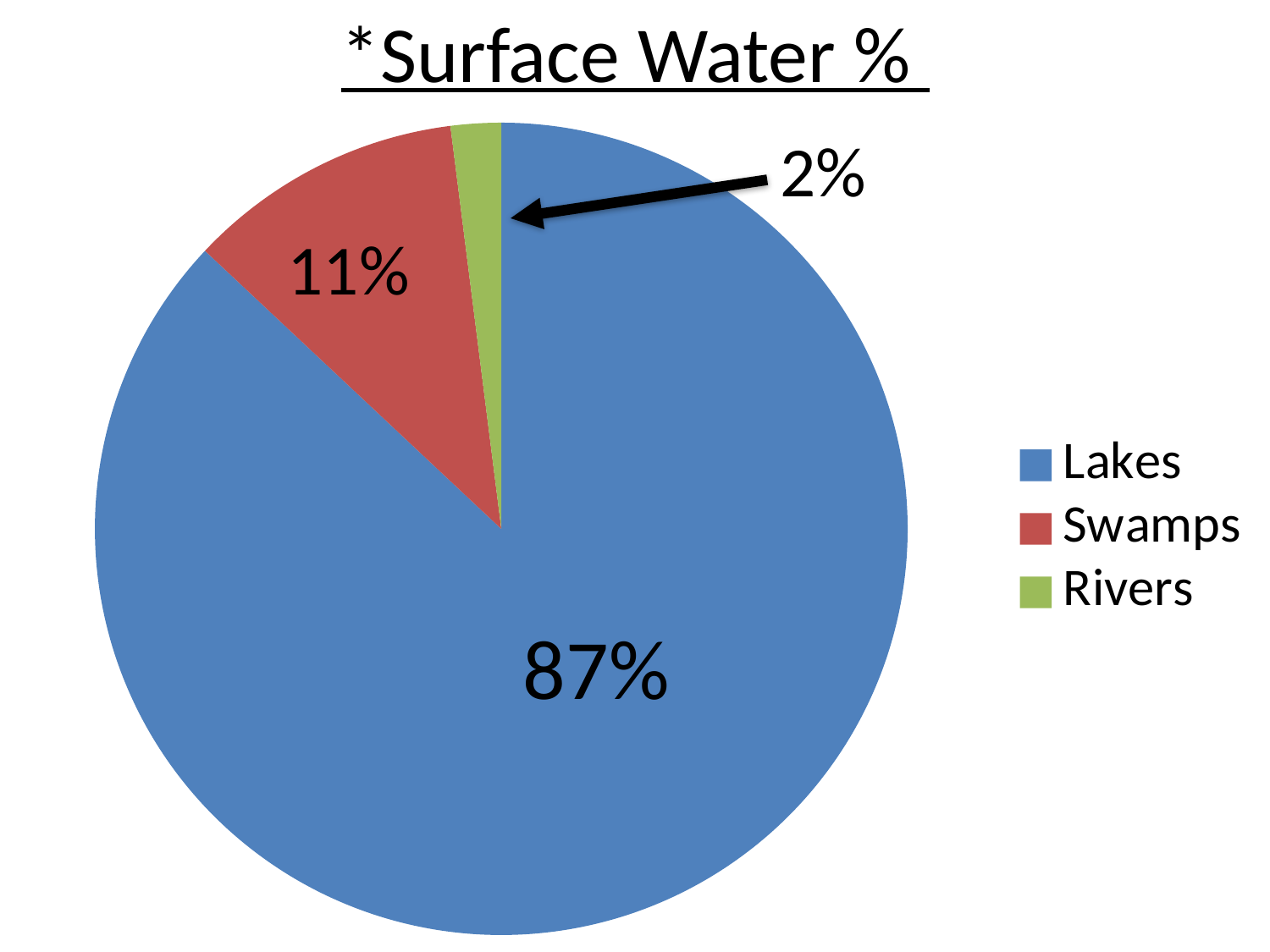
What kind of chart is shown on the slide? Pie chart Which category has the largest share of surface water? Lakes Which category has the smallest share of surface water? Rivers Which has a larger share of surface water, Swamps or Rivers? Swamps What percentage of surface water is Swamps? 11% How many categories are shown in the pie chart? 3 What percentage of surface water is Lakes? 87% What percentage of surface water is Rivers? 2% What is the title of the chart? *Surface Water % What is the difference in percentage points between Swamps and Rivers? 9 What is the difference in percentage points between Lakes and Swamps? 76 Which colour represents Swamps in the pie chart? Red